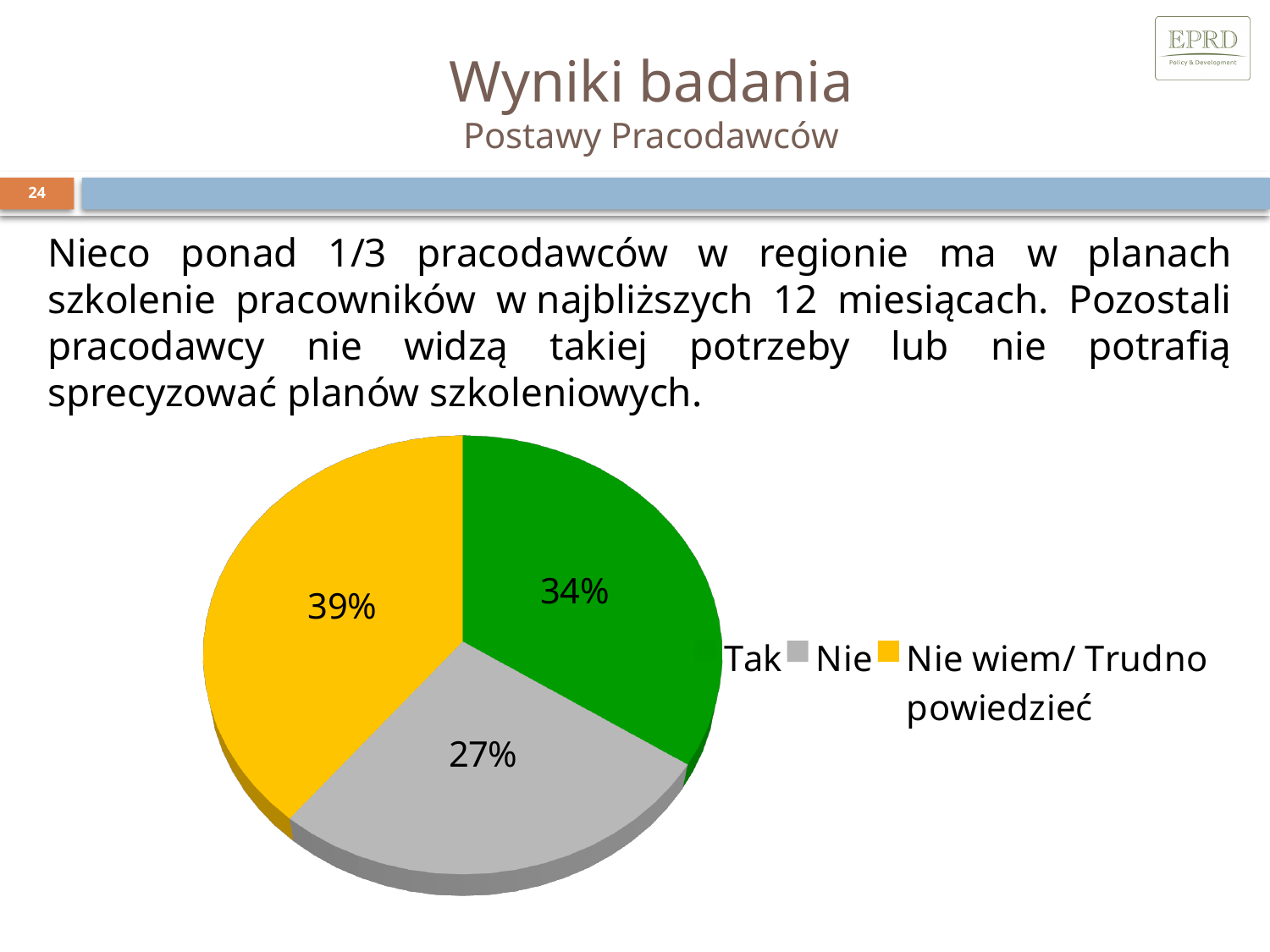
What is the difference in percentage points between the "Tak" slice and the "Nie" slice? 7 percentage points What share of the pie does the "Nie" slice represent? 27% What kind of chart is shown on the slide? pie chart What share of the pie does the "Tak" slice represent? 34% What share of the pie does the "Nie wiem/ Trudno powiedzieć" slice represent? 39% Which category has the smallest slice of the pie? Nie How many entries does the legend list? 3 Which slice is larger, "Tak" or "Nie"? Tak What is the difference in percentage points between the "Nie wiem/ Trudno powiedzieć" slice and the "Tak" slice? 5 percentage points Which category has the largest slice of the pie? Nie wiem/ Trudno powiedzieć What colour is the "Nie" slice in the pie chart? grey How many slices does the pie chart have? 3